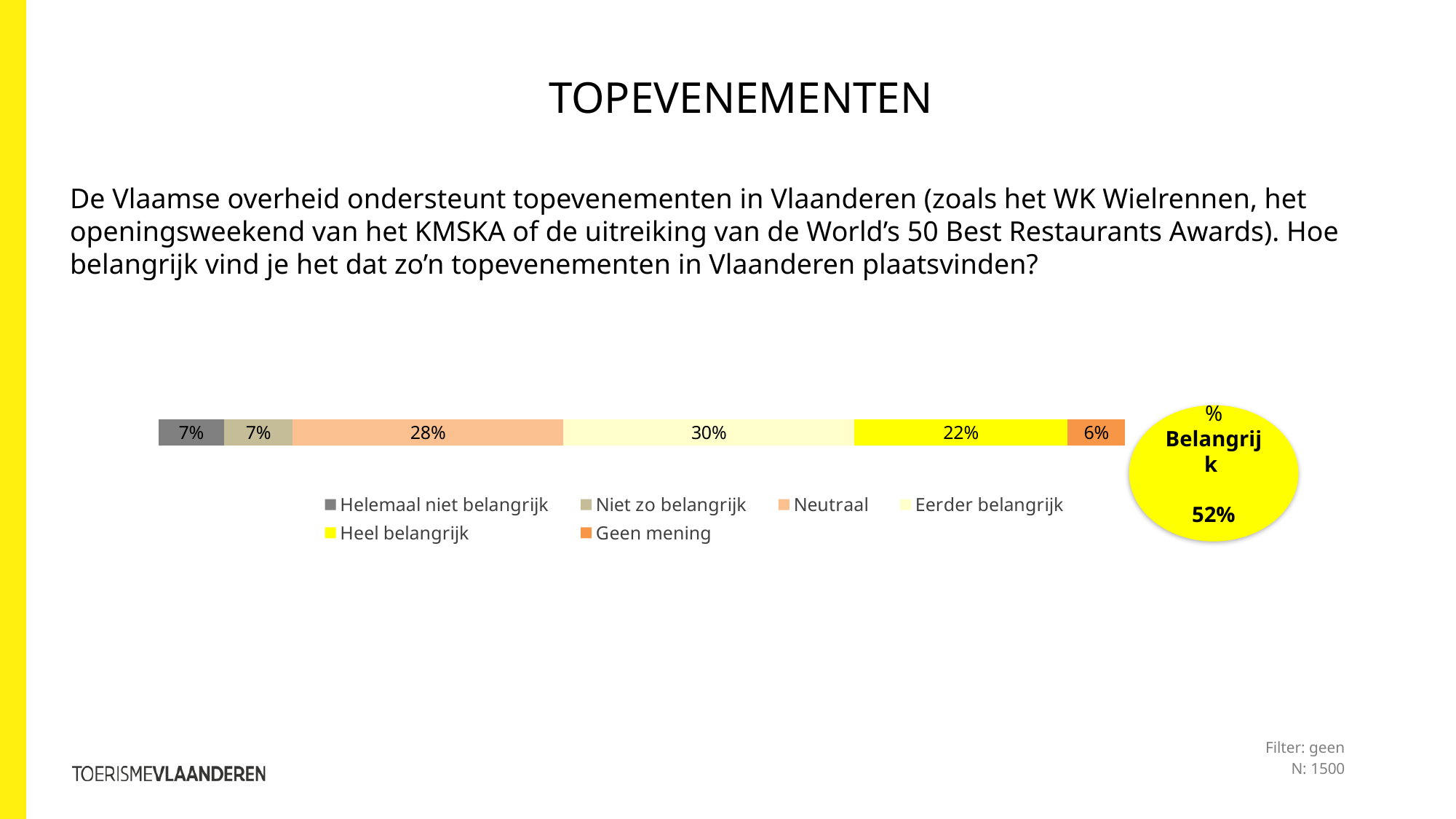
Which response category has the smallest share in the bar? Geen mening What is the difference between the "Eerder belangrijk" share and the "Heel belangrijk" share? 8% What percentage of respondents answered "Eerder belangrijk"? 30% How many series does the legend list? 6 What percentage is shown in the yellow circle labelled "% Belangrijk"? 52% What kind of chart is shown on the slide? Stacked bar chart What percentage of respondents answered "Heel belangrijk"? 22% What is the combined share of "Eerder belangrijk" and "Heel belangrijk"? 52% What percentage of respondents answered "Geen mening"? 6% Which is larger: the share for "Neutraal" or the share for "Heel belangrijk"? Neutraal Which response category has the largest share in the bar? Eerder belangrijk What percentage of respondents answered "Neutraal"? 28%